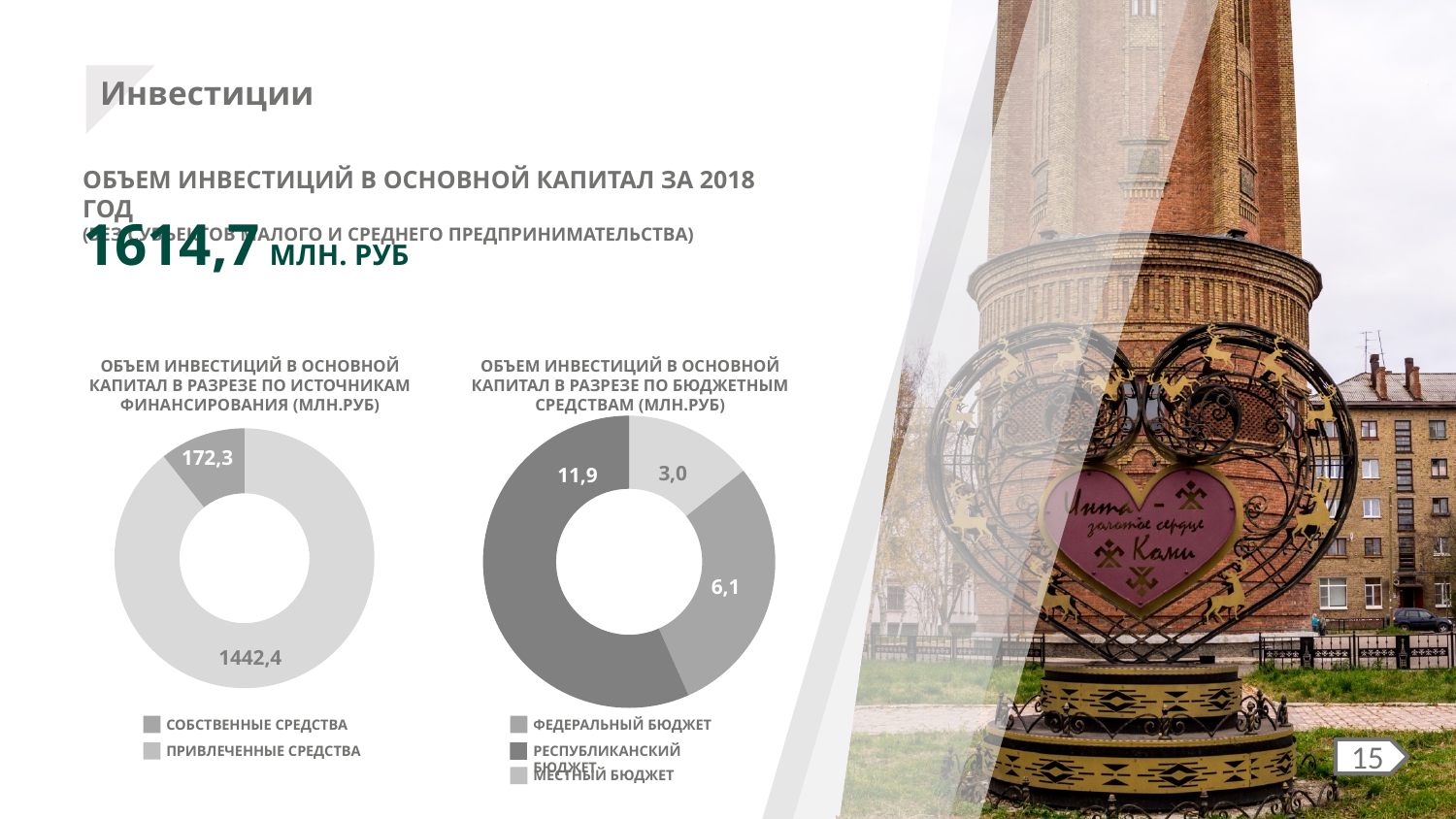
How many entries does the legend of the left chart (по источникам финансирования) list? 2 In the right chart (по бюджетным средствам), what is the smallest slice value? 3,0 In the right chart (по бюджетным средствам), what is the difference between the largest and smallest slice values? 8,9 In the left chart (по источникам финансирования), what is the total of the two slices? 1614,7 What type of chart is used for the left chart, 'Объем инвестиций в основной капитал в разрезе по источникам финансирования'? Pie (donut) chart What are the three legend entries of the right chart (по бюджетным средствам)? Федеральный бюджет, Республиканский бюджет, Местный бюджет In the right chart (по бюджетным средствам), what is the total of all three slices? 21,0 In the left chart (по источникам финансирования), what is the difference between the two slice values? 1270,1 In the left chart (по источникам финансирования), what is the largest value shown? 1442,4 How many slices does the right chart (по бюджетным средствам) have? 3 In the left chart (по источникам финансирования), what is the smallest value shown? 172,3 In the right chart (по бюджетным средствам), what is the largest slice value? 11,9